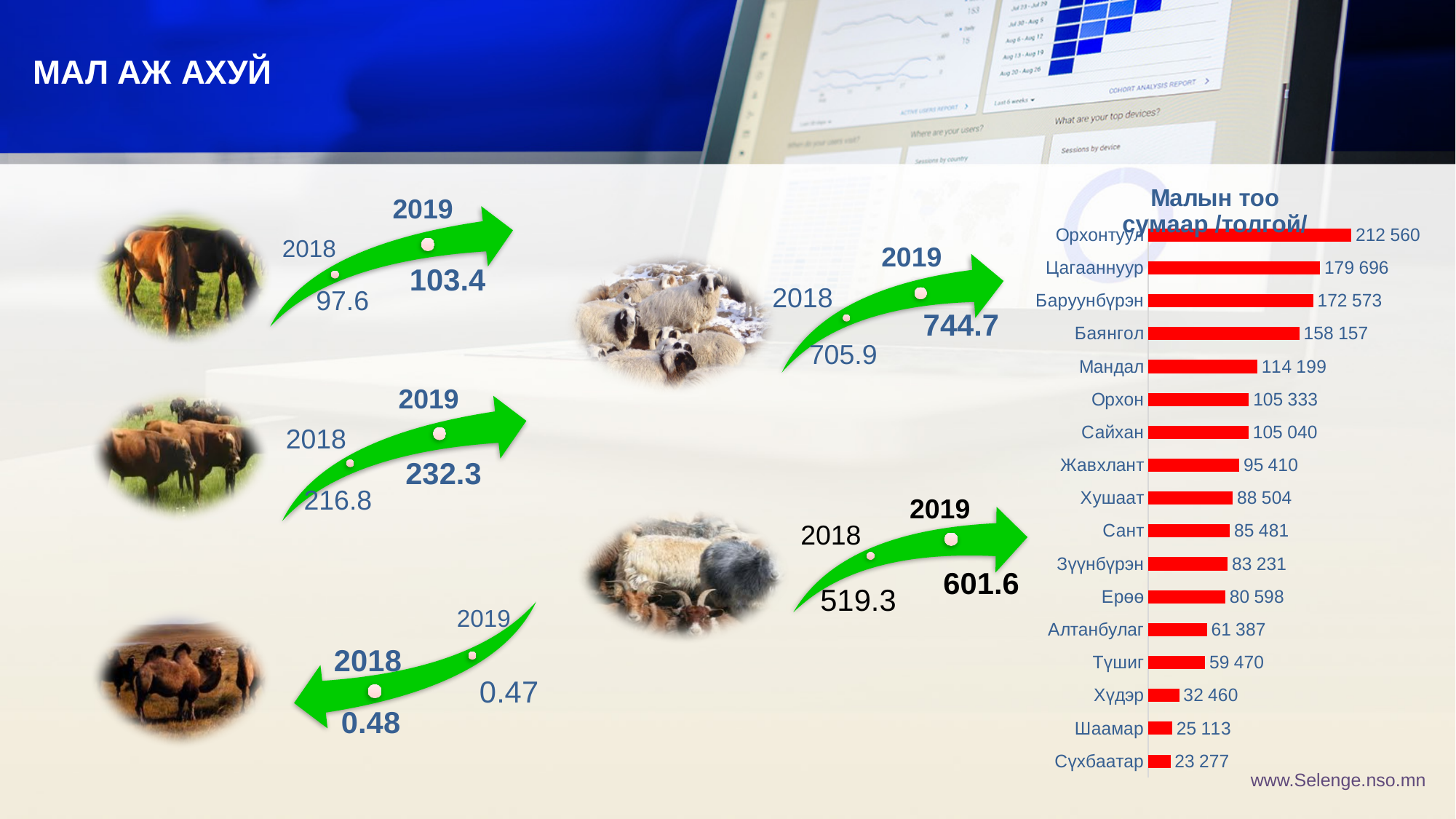
In the bar chart 'Малын тоо сумаар /толгой/', which category has the lowest value? Сүхбаатар In the bar chart 'Малын тоо сумаар /толгой/', what is the value for Түшиг? 59 470 In the bar chart 'Малын тоо сумаар /толгой/', which is larger, Баруунбүрэн or Баянгол? Баруунбүрэн What kind of chart is 'Малын тоо сумаар /толгой/'? Bar chart In the bar chart 'Малын тоо сумаар /толгой/', what is the value for Мандал? 114 199 How many categories are shown in the bar chart 'Малын тоо сумаар /толгой/'? 17 In the bar chart 'Малын тоо сумаар /толгой/', what is the difference between Орхонтуул and Цагааннуур? 32 864 What colour are the bars in the chart 'Малын тоо сумаар /толгой/'? Red In the bar chart 'Малын тоо сумаар /толгой/', what is the value for Орхонтуул? 212 560 In the bar chart 'Малын тоо сумаар /толгой/', what is the difference between Баянгол and Мандал? 43 958 In the bar chart 'Малын тоо сумаар /толгой/', which category has the highest value? Орхонтуул In the bar chart 'Малын тоо сумаар /толгой/', which is larger, Хушаат or Ерөө? Хушаат